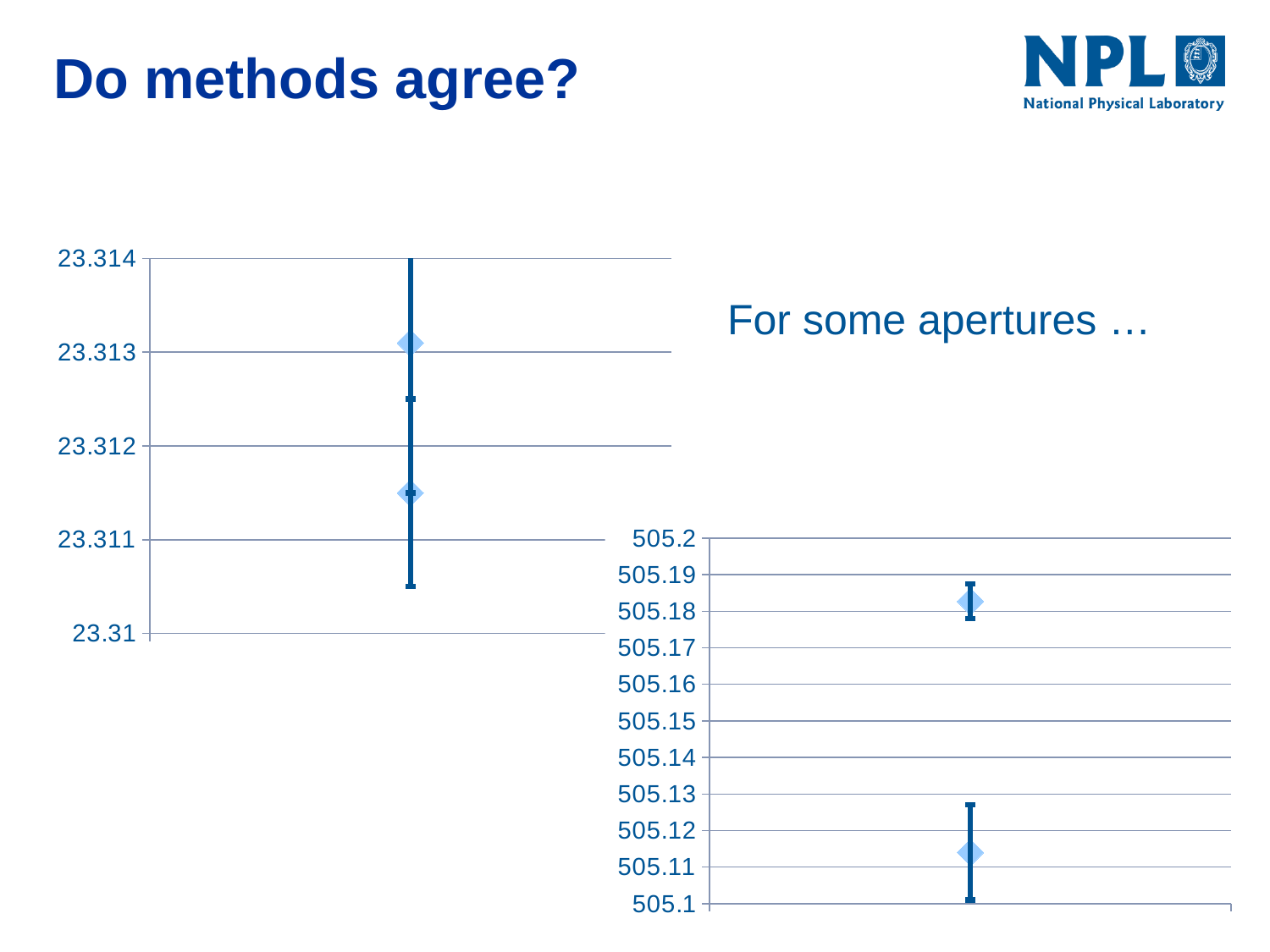
How many charts are shown on the slide? 2 In the right chart, is the value of the upper data point greater or less than 505.19? less In the right chart, how many data points are plotted? 2 What kind of chart is the left chart? Scatter chart with error bars In the left chart, how many data points are plotted? 2 What is the highest value shown on the y axis of the left chart? 23.314 In the left chart, which of the two plotted points has the larger value, the upper one or the lower one? the upper one What is the lowest value shown on the y axis of the right chart? 505.1 In the right chart, is the value of the upper data point greater or less than 505.17? greater In the left chart, is the value of the lower data point greater or less than 23.311? greater